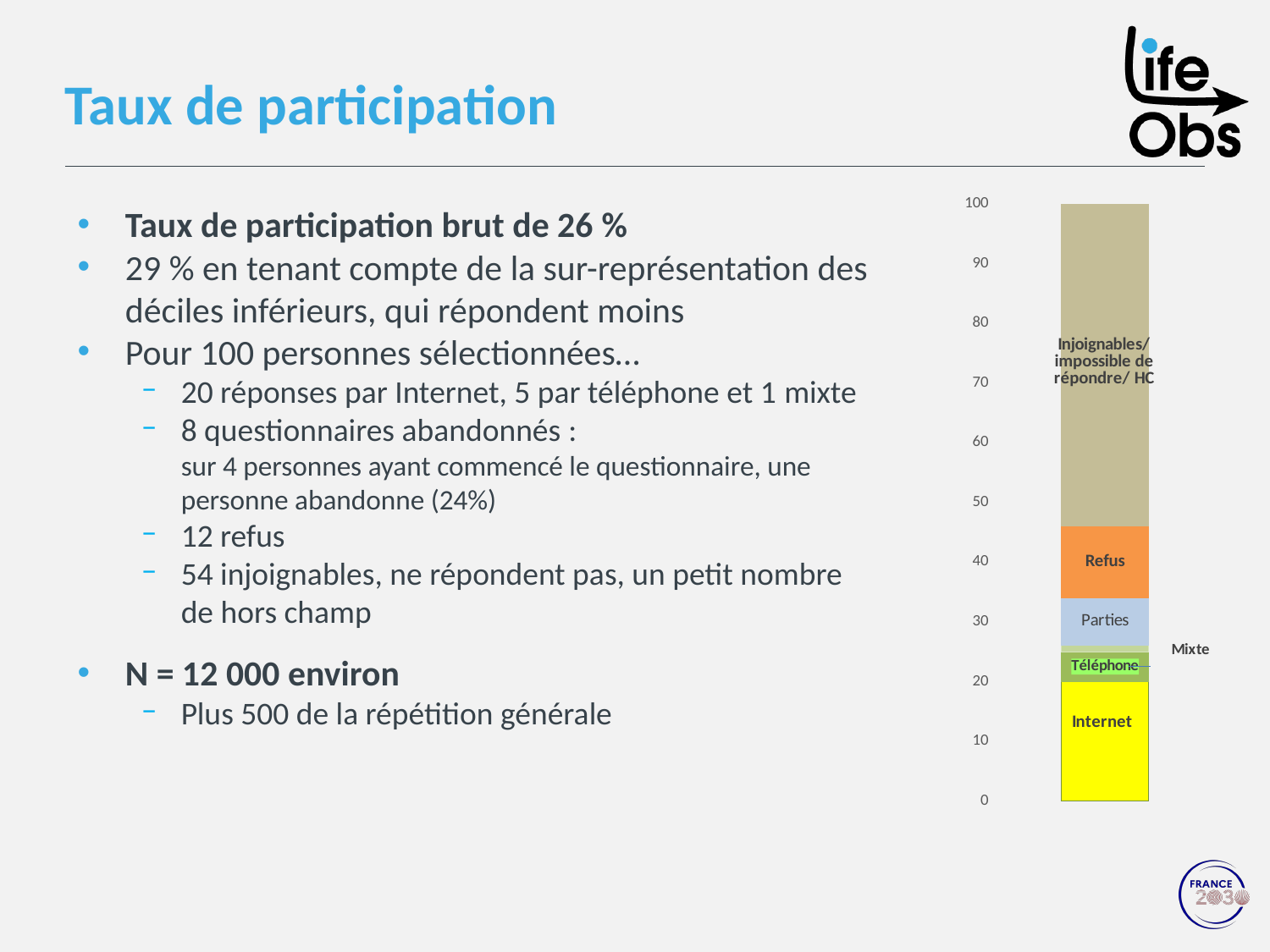
What colour is the Refus segment of the bar? Orange What is the total height of the stacked bar on the axis? 100 How many segments make up the stacked bar in the chart? 6 At what value on the axis does the top of the Internet segment land? 20 Is the top of the Refus segment greater or less than 40 on the axis? greater Which segment of the stacked bar is the smallest? Mixte Which segment of the stacked bar is the largest? Injoignables/ impossible de répondre/ HC Is the top of the Parties segment greater or less than 40 on the axis? less What kind of chart is shown on the right of the slide? Stacked bar chart Which segment is larger, Refus or Parties? Refus What colour is the Internet segment of the bar? Yellow Which segment is larger, Internet or Téléphone? Internet